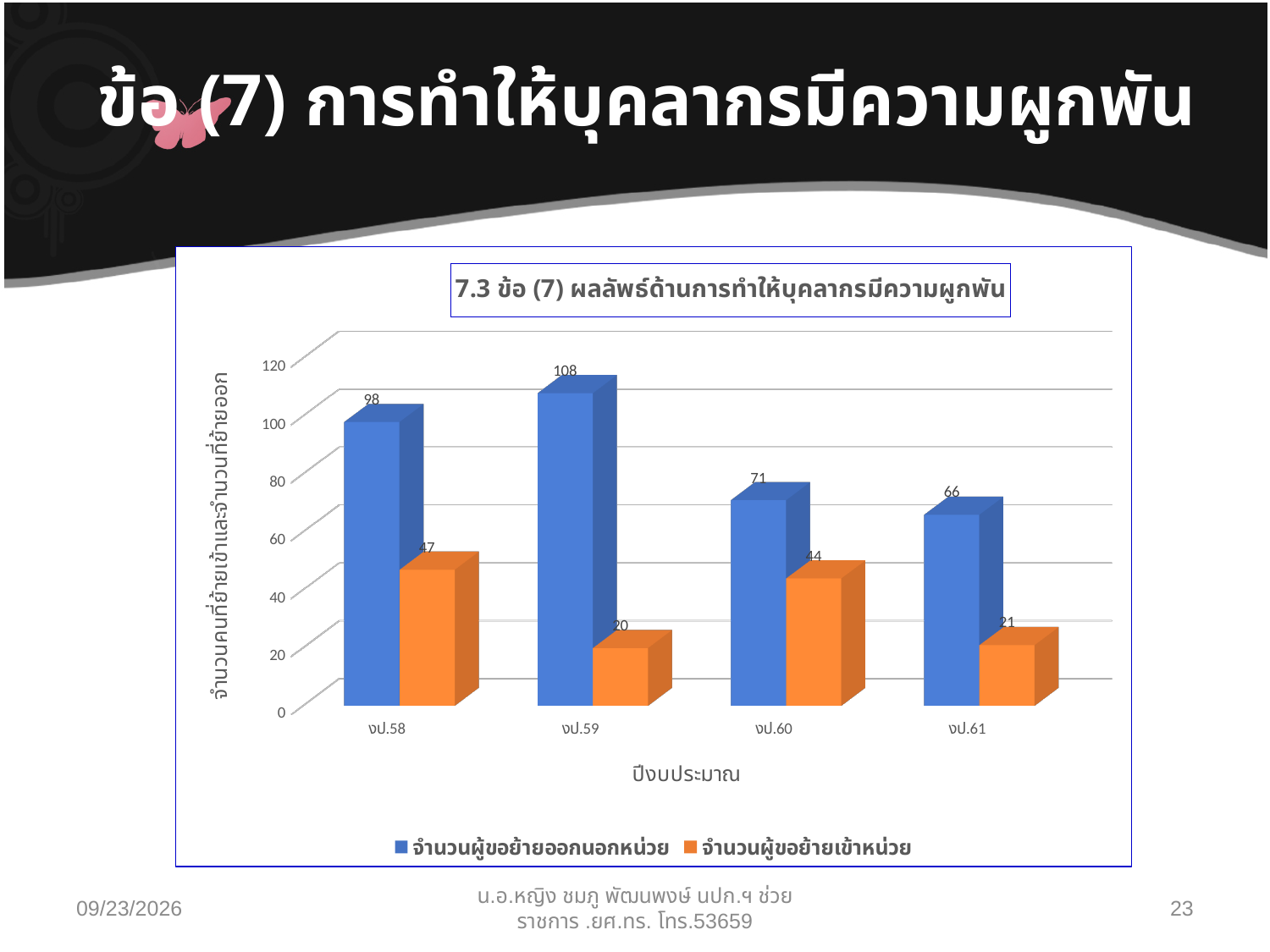
What is the value of จำนวนผู้ขอย้ายออกนอกหน่วย for งป.59? 108 Does จำนวนผู้ขอย้ายออกนอกหน่วย rise or fall from งป.59 to งป.61? fall What is the value of จำนวนผู้ขอย้ายออกนอกหน่วย for งป.61? 66 In which year is จำนวนผู้ขอย้ายออกนอกหน่วย highest? งป.59 What type of chart is shown on the slide? bar chart What is the difference between จำนวนผู้ขอย้ายออกนอกหน่วย and จำนวนผู้ขอย้ายเข้าหน่วย in งป.59? 88 How many series does the legend list? 2 What is the value of จำนวนผู้ขอย้ายเข้าหน่วย for งป.58? 47 In which year is จำนวนผู้ขอย้ายเข้าหน่วย lowest? งป.59 How many fiscal-year categories are shown on the x axis? 4 Which is larger in งป.60: จำนวนผู้ขอย้ายออกนอกหน่วย or จำนวนผู้ขอย้ายเข้าหน่วย? จำนวนผู้ขอย้ายออกนอกหน่วย What is the title of the chart? 7.3 ข้อ (7) ผลลัพธ์ด้านการทำให้บุคลากรมีความผูกพัน